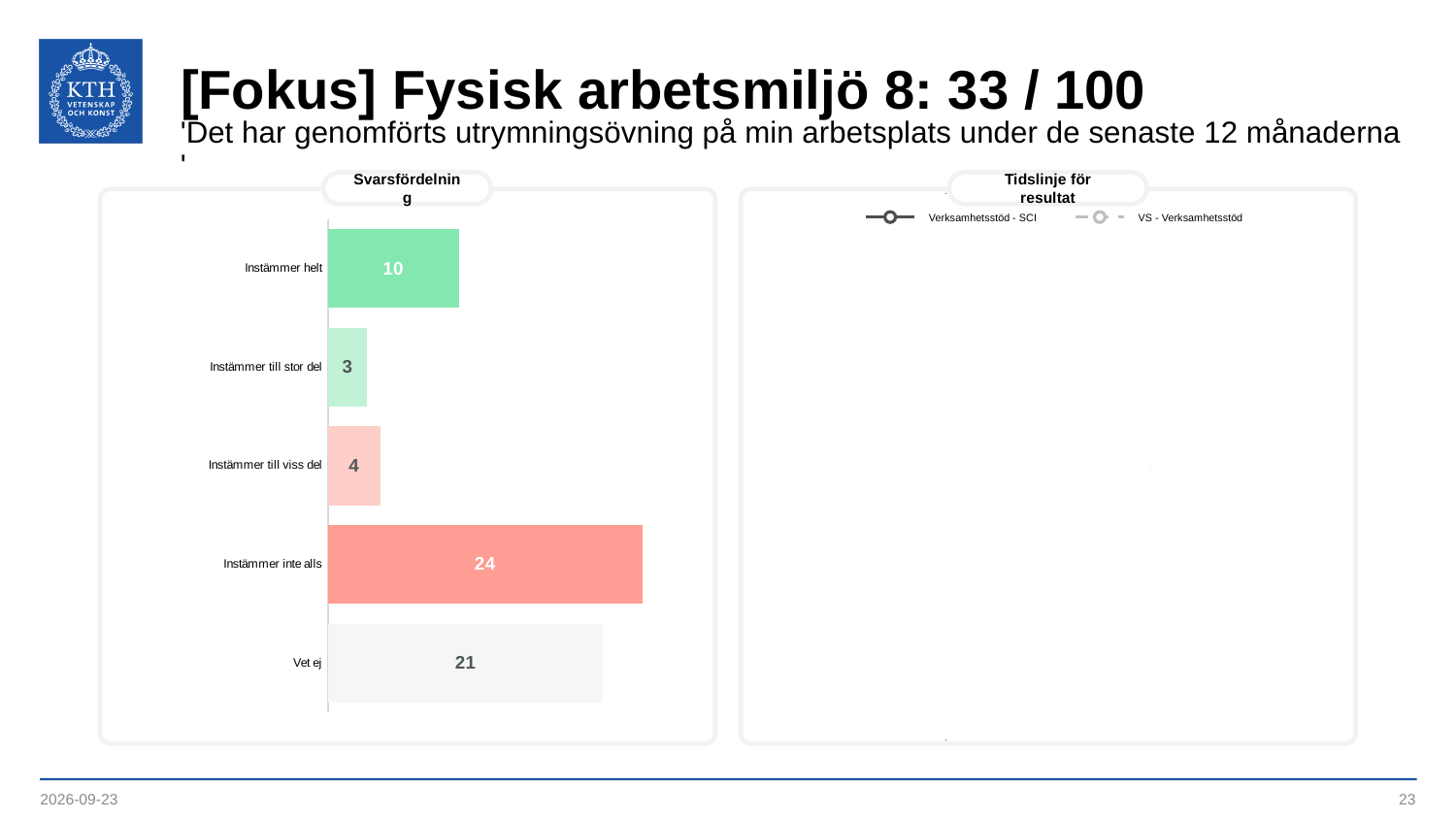
What kind of chart is the Svarsfördelning chart? Bar chart In the Svarsfördelning chart, which is larger: Instämmer helt or Instämmer till viss del? Instämmer helt How many categories does the Svarsfördelning chart show? 5 In the Svarsfördelning chart, what is the difference between Instämmer inte alls and Vet ej? 3 What is the title of the chart on the right side of the slide? Tidslinje för resultat How many series does the legend of the Tidslinje för resultat chart list? 2 In the Svarsfördelning chart, which category has the lowest value? Instämmer till stor del In the Svarsfördelning chart, what is the value for Instämmer till viss del? 4 In the Svarsfördelning chart, what is the value for Vet ej? 21 In the Svarsfördelning chart, what is the value for Instämmer inte alls? 24 In the Svarsfördelning chart, what is the value for Instämmer helt? 10 In the Svarsfördelning chart, which category has the highest value? Instämmer inte alls